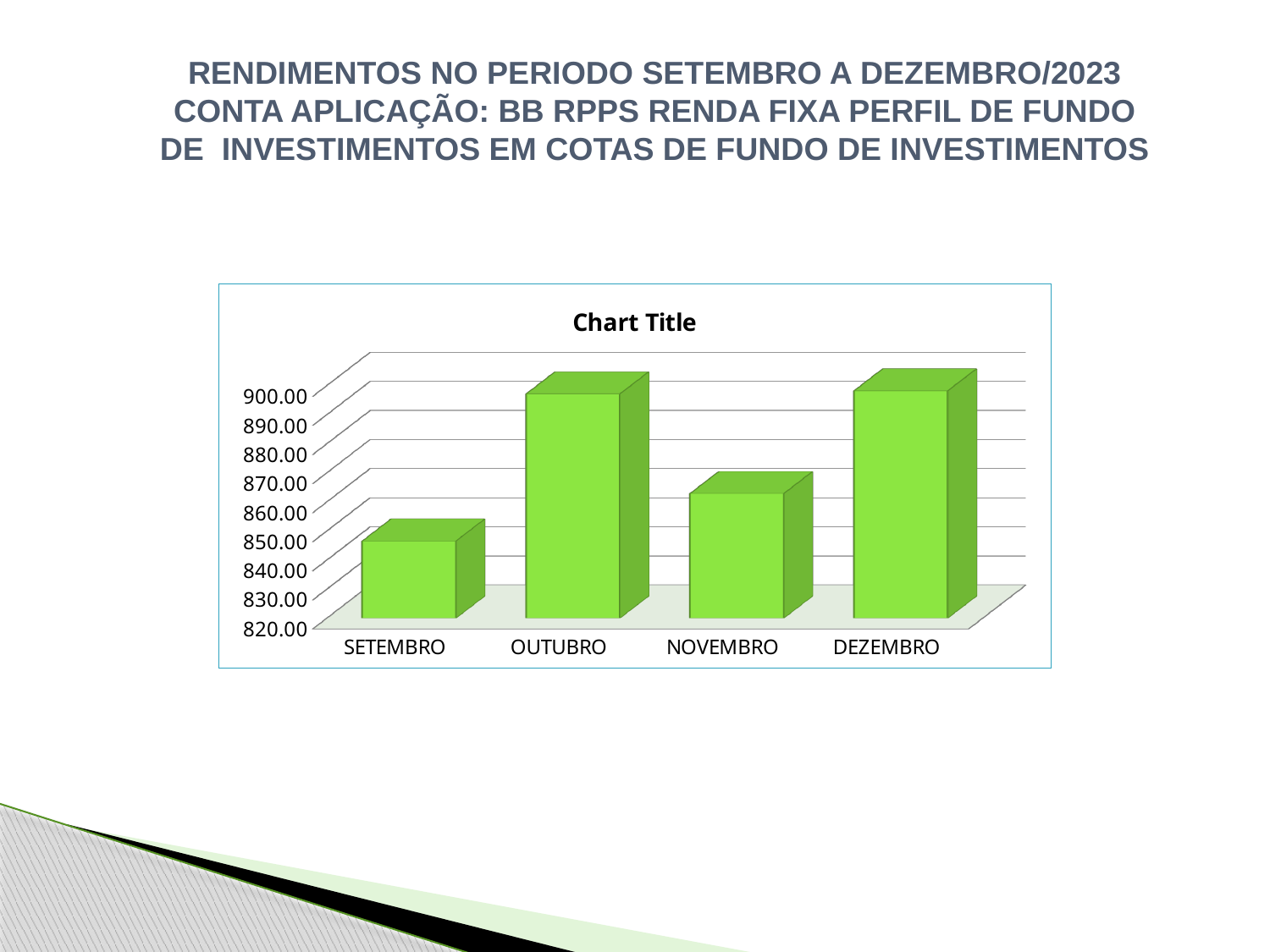
Is the value for NOVEMBRO greater or less than 880? less Is the value for DEZEMBRO greater or less than 880? greater What colour are the bars in the chart? green Is the value for OUTUBRO greater or less than 880? greater What kind of chart is shown on the slide? bar chart Which is larger, the value for OUTUBRO or the value for NOVEMBRO? OUTUBRO What is the title printed above the chart's plot area? Chart Title Which month has the lowest value in the chart? SETEMBRO Does the value rise or fall from SETEMBRO to OUTUBRO? rise How many categories are shown on the x axis of the chart? 4 Which is larger, the value for SETEMBRO or the value for NOVEMBRO? NOVEMBRO